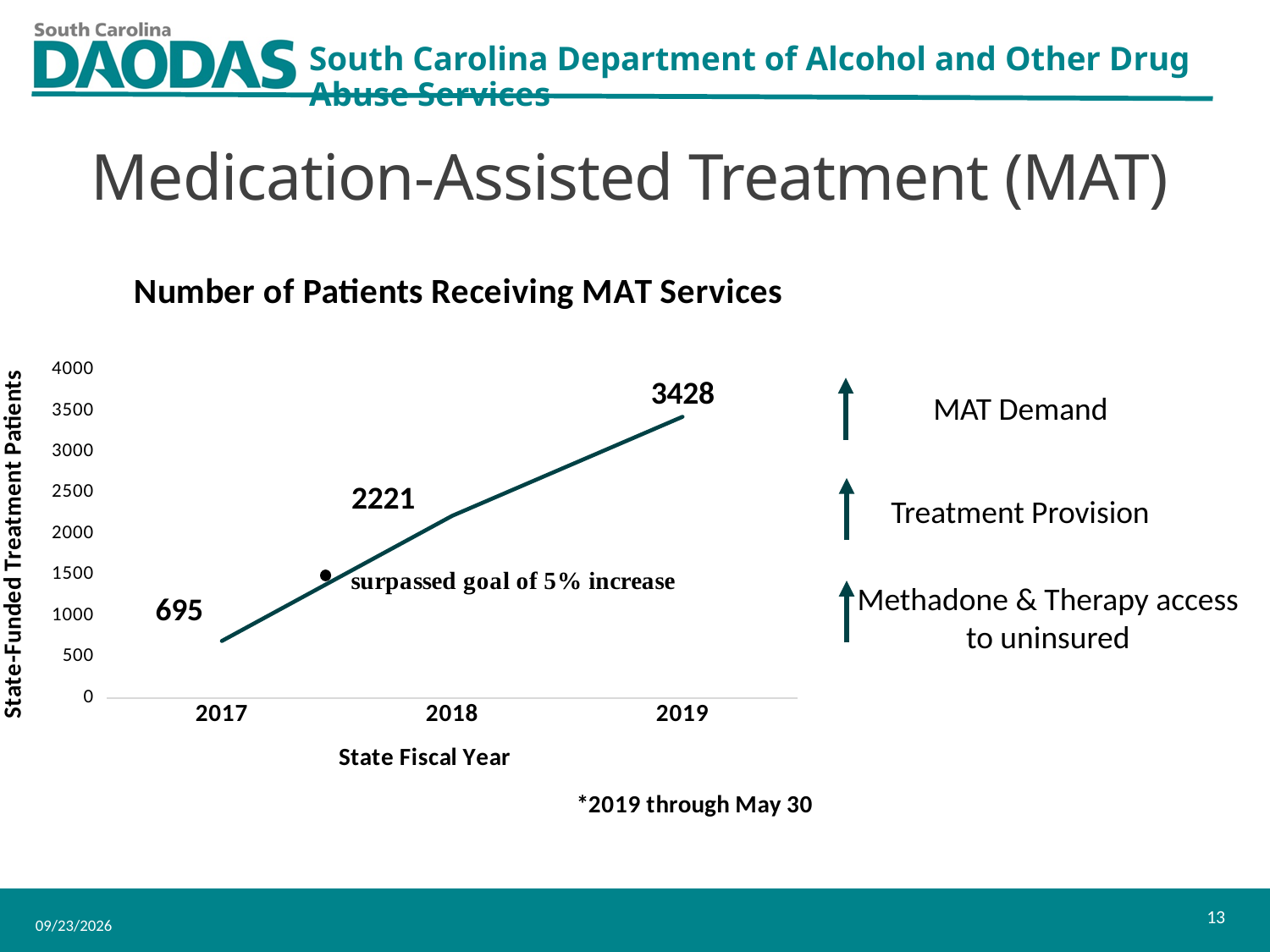
Which state fiscal year has the lowest number of patients receiving MAT services? 2017 Which year has more patients receiving MAT services, 2018 or 2019? 2019 Which state fiscal year has the highest number of patients receiving MAT services? 2019 Does the number of patients receiving MAT services rise or fall from 2017 to 2019? rise What is the difference in the number of patients between 2019 and 2017? 2733 What is the difference in the number of patients between 2018 and 2017? 1526 How many state fiscal years are plotted on the chart? 3 What is the number of patients receiving MAT services in 2018? 2221 What is the number of patients receiving MAT services in 2019? 3428 Is the value for 2018 greater or less than 2000? greater What kind of chart is used to show the number of patients receiving MAT services? line chart What is the number of patients receiving MAT services in 2017? 695